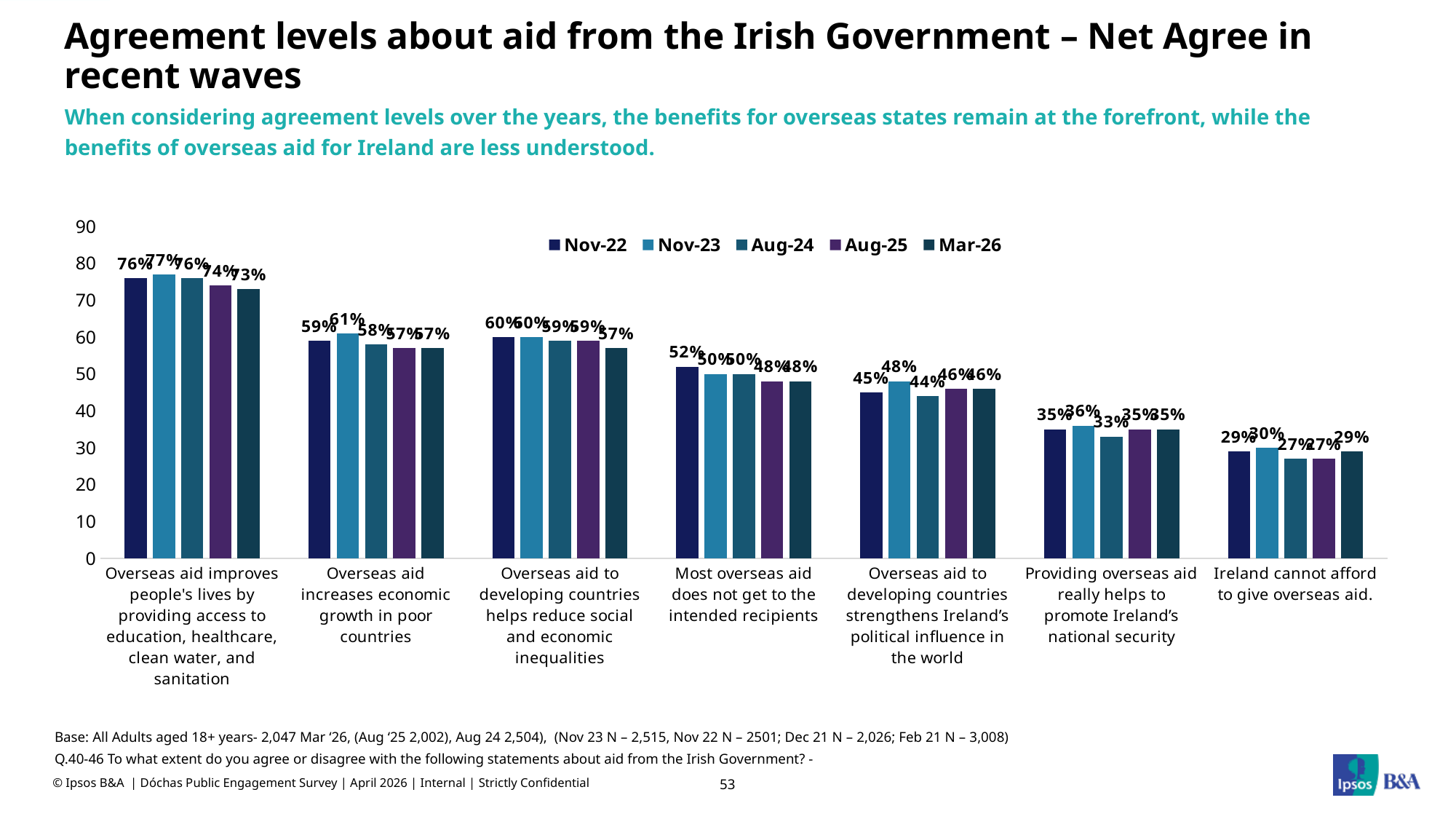
Which statement has the highest Mar-26 net agree value? Overseas aid improves people's lives by providing access to education, healthcare, clean water, and sanitation How many statements (categories) are shown on the x axis? 7 What is the Nov-23 value for "Overseas aid increases economic growth in poor countries"? 61% What is the difference between the Nov-22 and Mar-26 values for "Overseas aid improves people's lives by providing access to education, healthcare, clean water, and sanitation"? 3 percentage points Is the Mar-26 value for "Overseas aid to developing countries helps reduce social and economic inequalities" greater or less than 50? greater What is the Mar-26 value for "Ireland cannot afford to give overseas aid"? 29% What kind of chart is shown on the slide? Bar chart What is the Nov-22 value for "Most overseas aid does not get to the intended recipients"? 52% How many survey waves (series) does the legend list? 5 What is the Aug-24 value for "Providing overseas aid really helps to promote Ireland's national security"? 33% Which is larger for "Overseas aid to developing countries strengthens Ireland's political influence in the world": the Nov-23 value or the Aug-24 value? Nov-23 Which statement has the lowest Nov-22 net agree value? Ireland cannot afford to give overseas aid